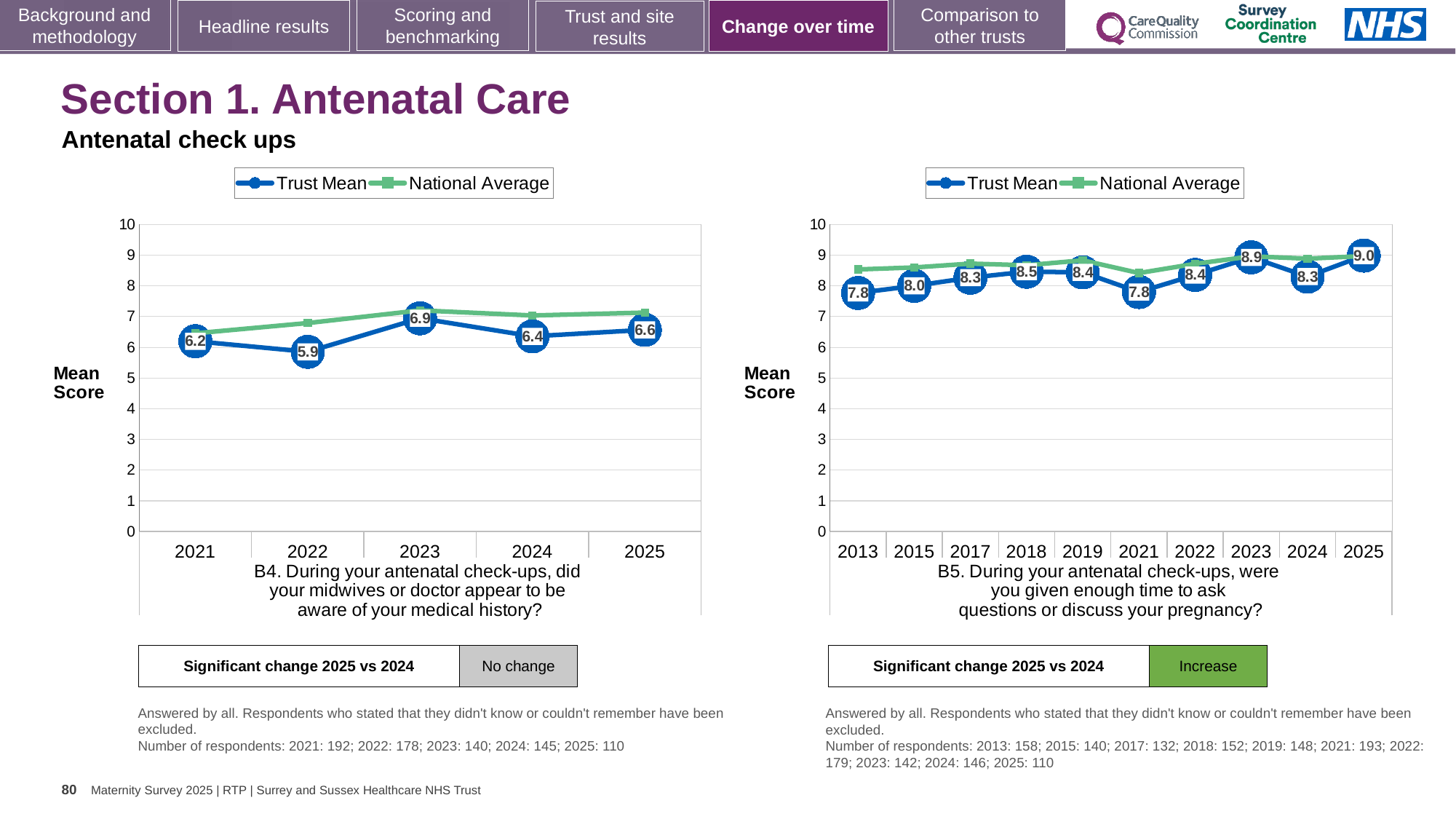
In the left chart (B4), which year has the highest Trust Mean score? 2023 In the left chart (B4), is the National Average for 2021 greater or less than 7? less In the right chart (B5), is the Trust Mean score for 2023 larger than the Trust Mean score for 2024? Yes How many series does the legend of the right chart (B5) list? 2 What kind of chart is the left chart (B4)? Line chart In the right chart (B5), what is the Trust Mean score for 2021? 7.8 In the left chart (B4), how many years are plotted on the x axis? 5 In the left chart (B4), what is the difference between the Trust Mean scores for 2023 and 2022? 1.0 In the right chart (B5), which year has the highest Trust Mean score? 2025 In the left chart (B4), what is the Trust Mean score for 2022? 5.9 In the right chart (B5), how many years are plotted on the x axis? 10 In the left chart (B4), which year has the lowest Trust Mean score? 2022